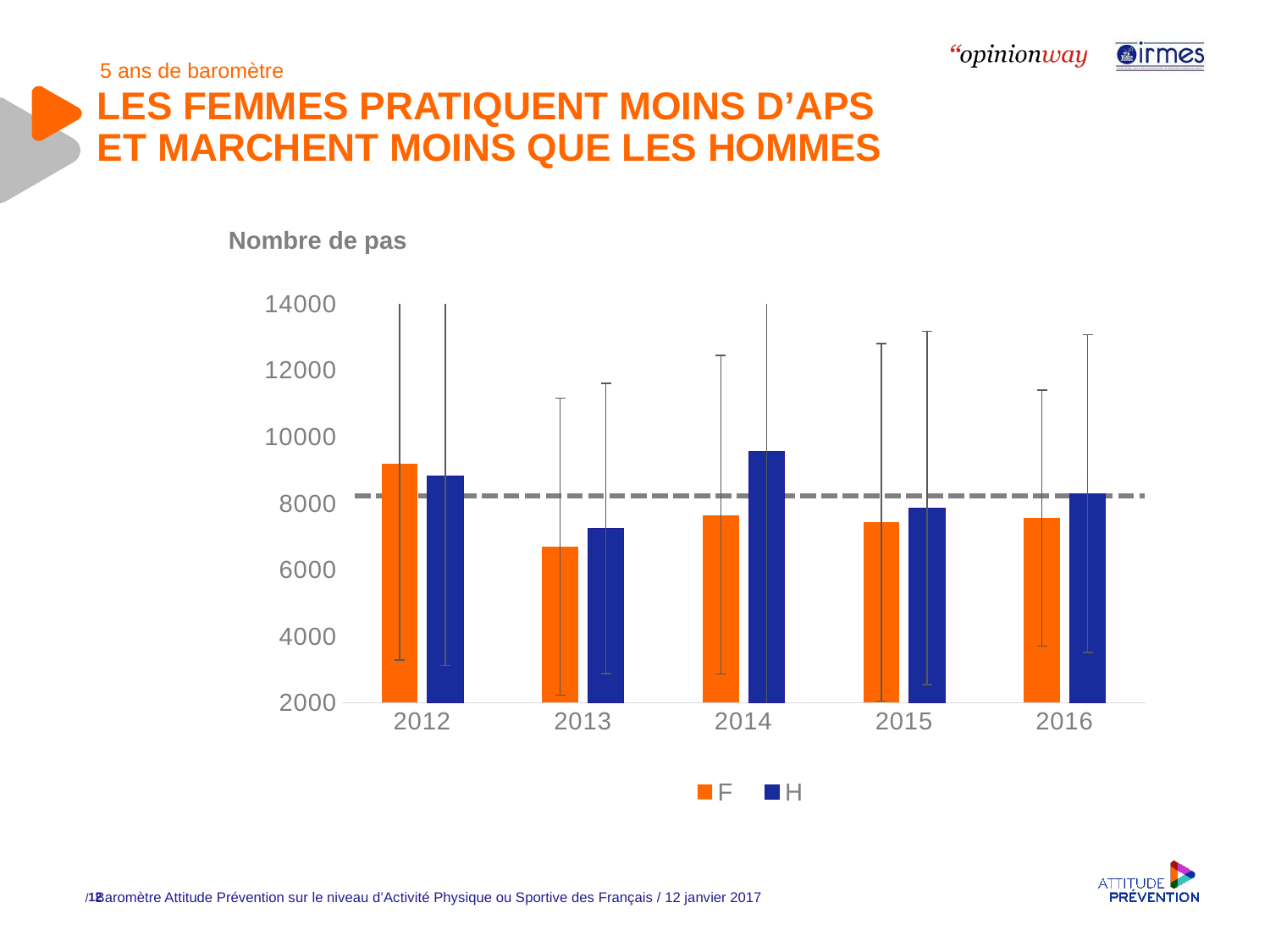
What is the title of the chart? Nombre de pas Is the value for F in 2013 greater or less than 8000? less How many years are shown on the x axis of the chart? 5 What kind of chart is shown on the slide? bar chart Is the value for F in 2012 greater or less than 8000? greater Which colour represents the F series in the chart? orange Is the value for H in 2013 greater or less than 8000? less In which year is the H series highest? 2014 How many series does the legend list? 2 In which year is the F series lowest? 2013 In 2014, which series has the larger value, F or H? H